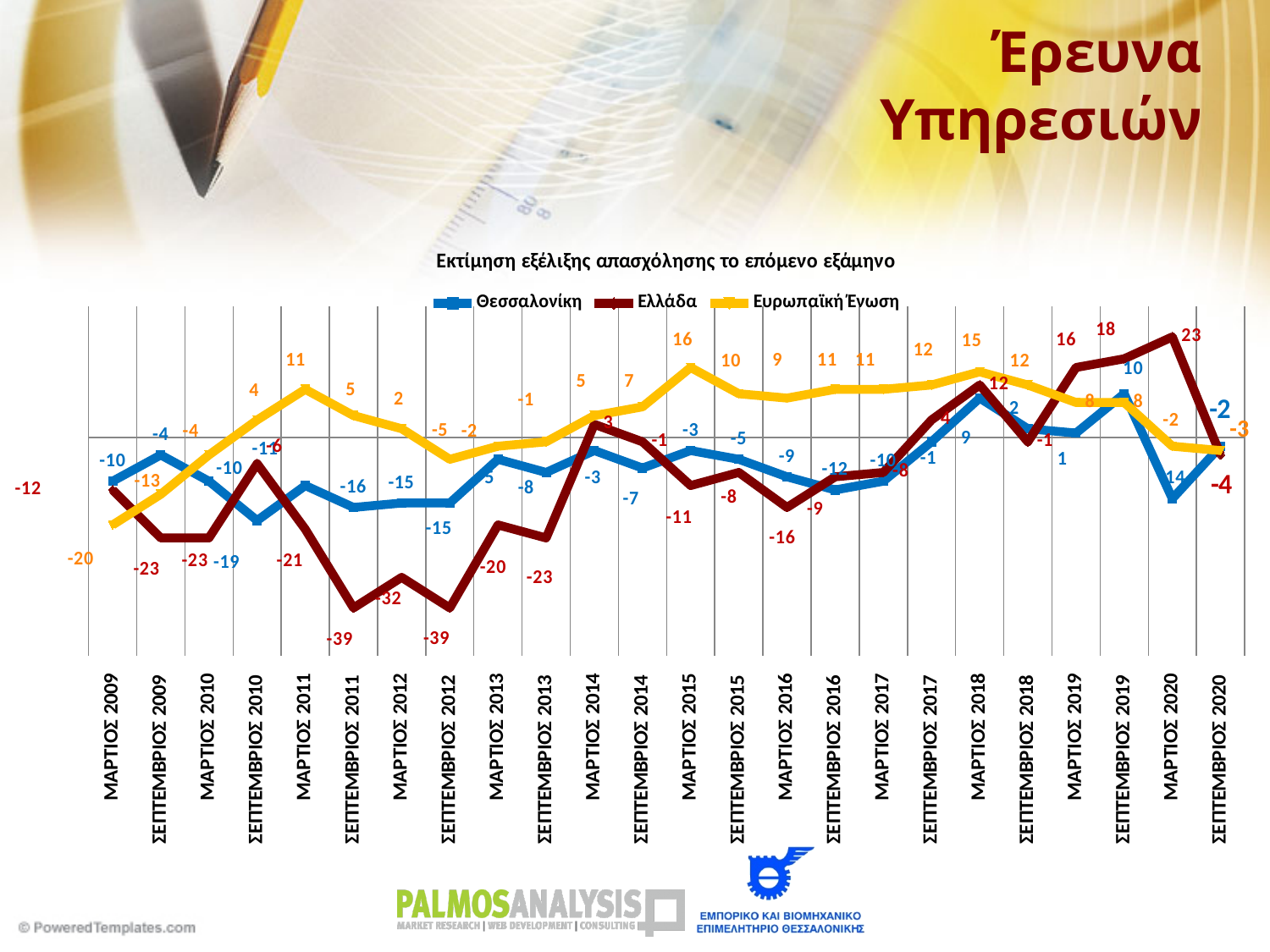
What is the value for Ελλάδα in ΜΑΡΤΙΟΣ 2020? 23 In ΜΑΡΤΙΟΣ 2015, which series has the higher value: Ευρωπαϊκή Ένωση or Ελλάδα? Ευρωπαϊκή Ένωση How many time points are shown on the x axis? 24 What is the difference between the Ελλάδα value (23) and the Θεσσαλονίκη value (-14) in ΜΑΡΤΙΟΣ 2020? 37 In which period does the Ελλάδα series reach its highest value? ΜΑΡΤΙΟΣ 2020 What is the value for Ελλάδα in ΣΕΠΤΕΜΒΡΙΟΣ 2011? -39 What kind of chart is shown on the slide? Line chart How many series does the legend list? 3 What is the value for Θεσσαλονίκη in ΣΕΠΤΕΜΒΡΙΟΣ 2020? -2 In which period does the Ευρωπαϊκή Ένωση series reach its highest value? ΜΑΡΤΙΟΣ 2015 What is the title of the chart? Εκτίμηση εξέλιξης απασχόλησης το επόμενο εξάμηνο What is the value for Ευρωπαϊκή Ένωση in ΜΑΡΤΙΟΣ 2015? 16